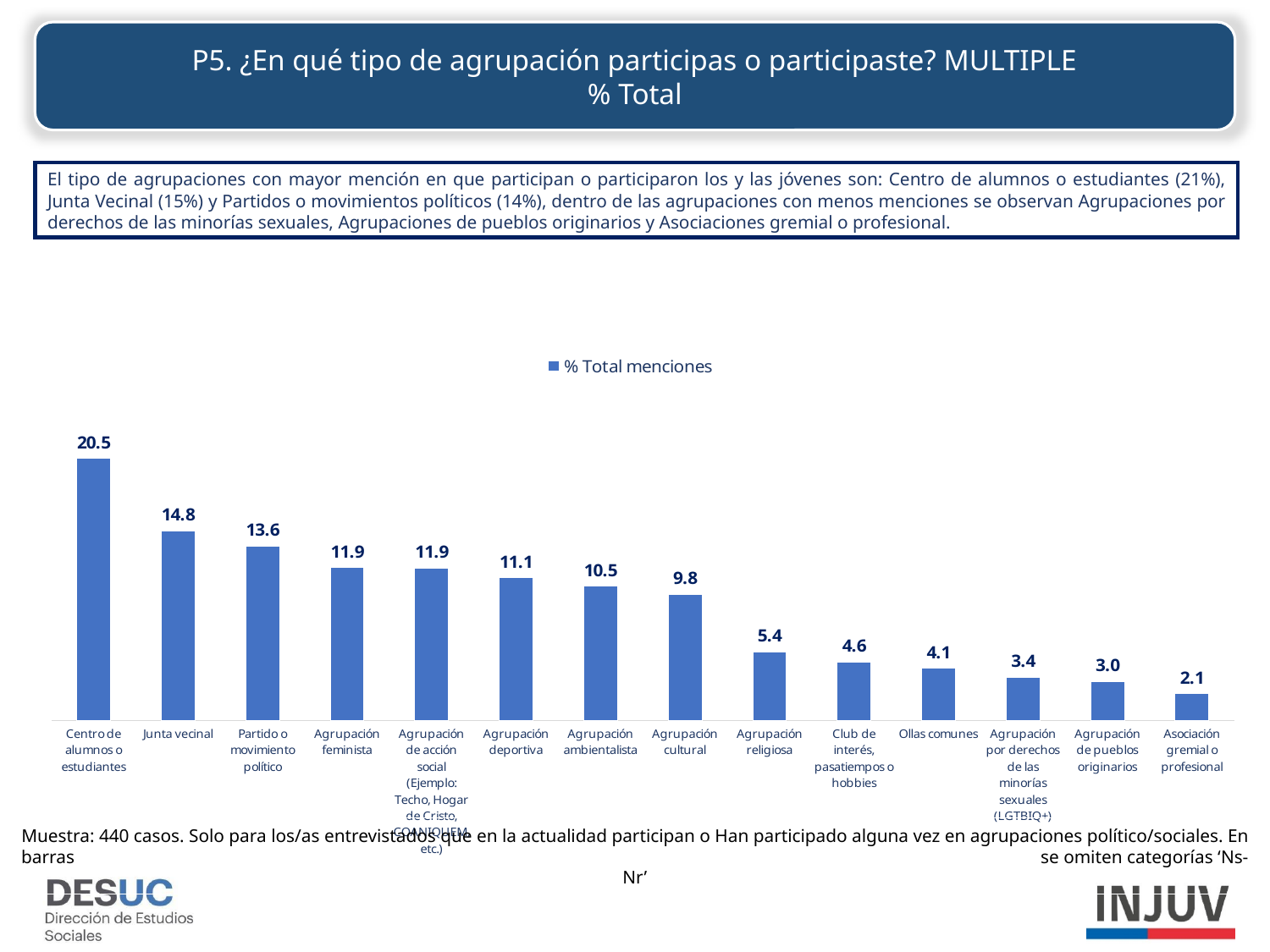
What is the value for Ollas comunes? 4.1 Which is larger, Agrupación deportiva or Agrupación ambientalista? Agrupación deportiva What is the value for Junta vecinal? 14.8 What is the difference between Centro de alumnos o estudiantes and Junta vecinal? 5.7 What kind of chart is shown on the slide? Bar chart What is the legend entry of the chart? % Total menciones How many categories are shown in the chart? 14 How many series does the legend list? 1 What is the difference between Agrupación religiosa and Agrupación de pueblos originarios? 2.4 What is the value for Agrupación cultural? 9.8 Which category has the highest value? Centro de alumnos o estudiantes Which category has the lowest value? Asociación gremial o profesional